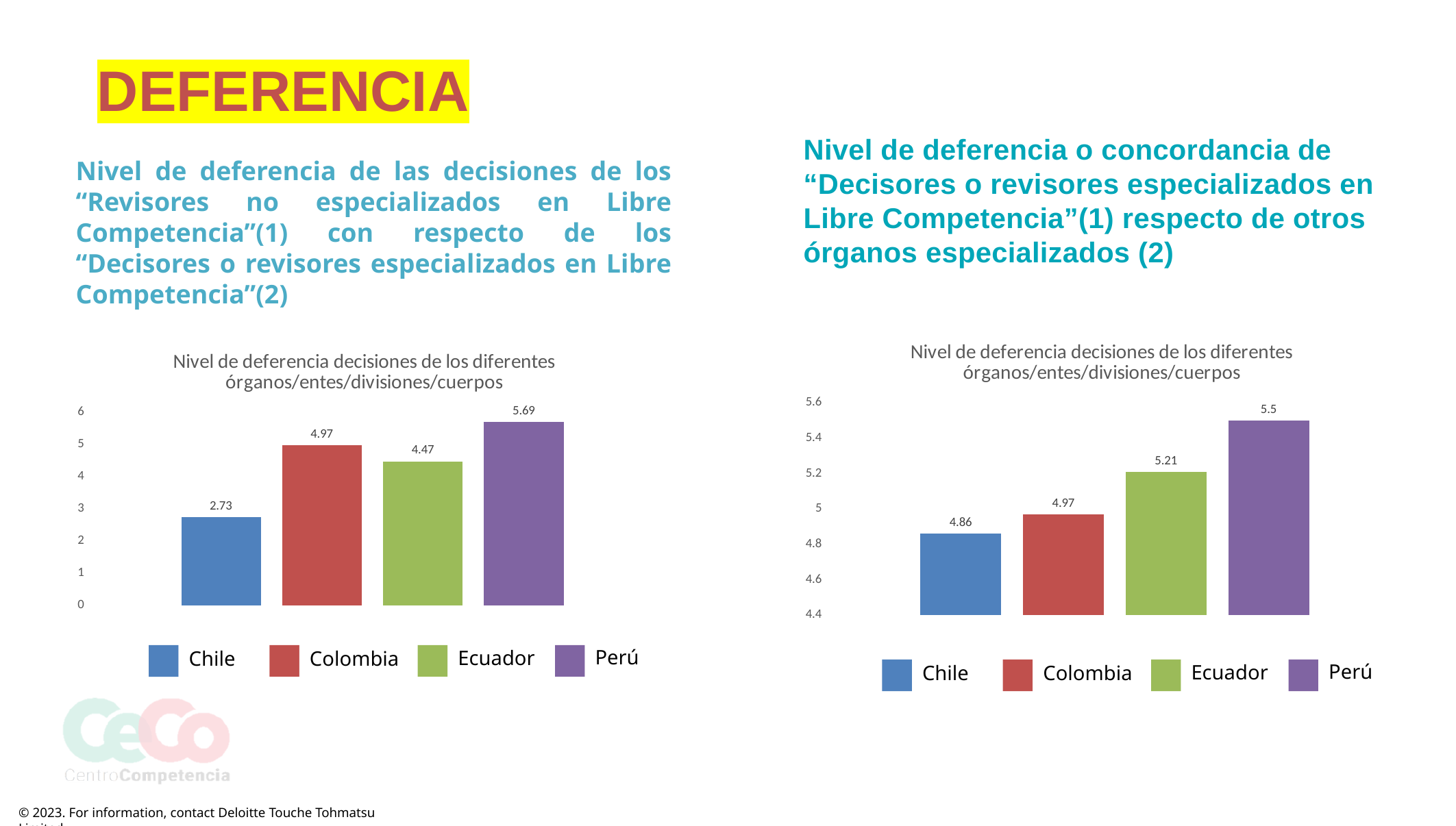
In the left chart, what is the value for Perú? 5.69 In the left chart, what is the difference between the values for Perú and Chile? 2.96 In the right chart, what is the difference between the values for Ecuador and Colombia? 0.24 In the left chart, what is the value for Chile? 2.73 In the right chart, do the values rise or fall from Chile to Perú? Rise In the right chart, what is the value for Chile? 4.86 What type of chart is the left chart? Bar chart How many countries does the legend of the right chart list? 4 In the left chart, which country has the lowest value? Chile In the left chart, which is larger, the value for Colombia or the value for Ecuador? Colombia In the right chart, what is the value for Ecuador? 5.21 In the right chart, which country has the highest value? Perú